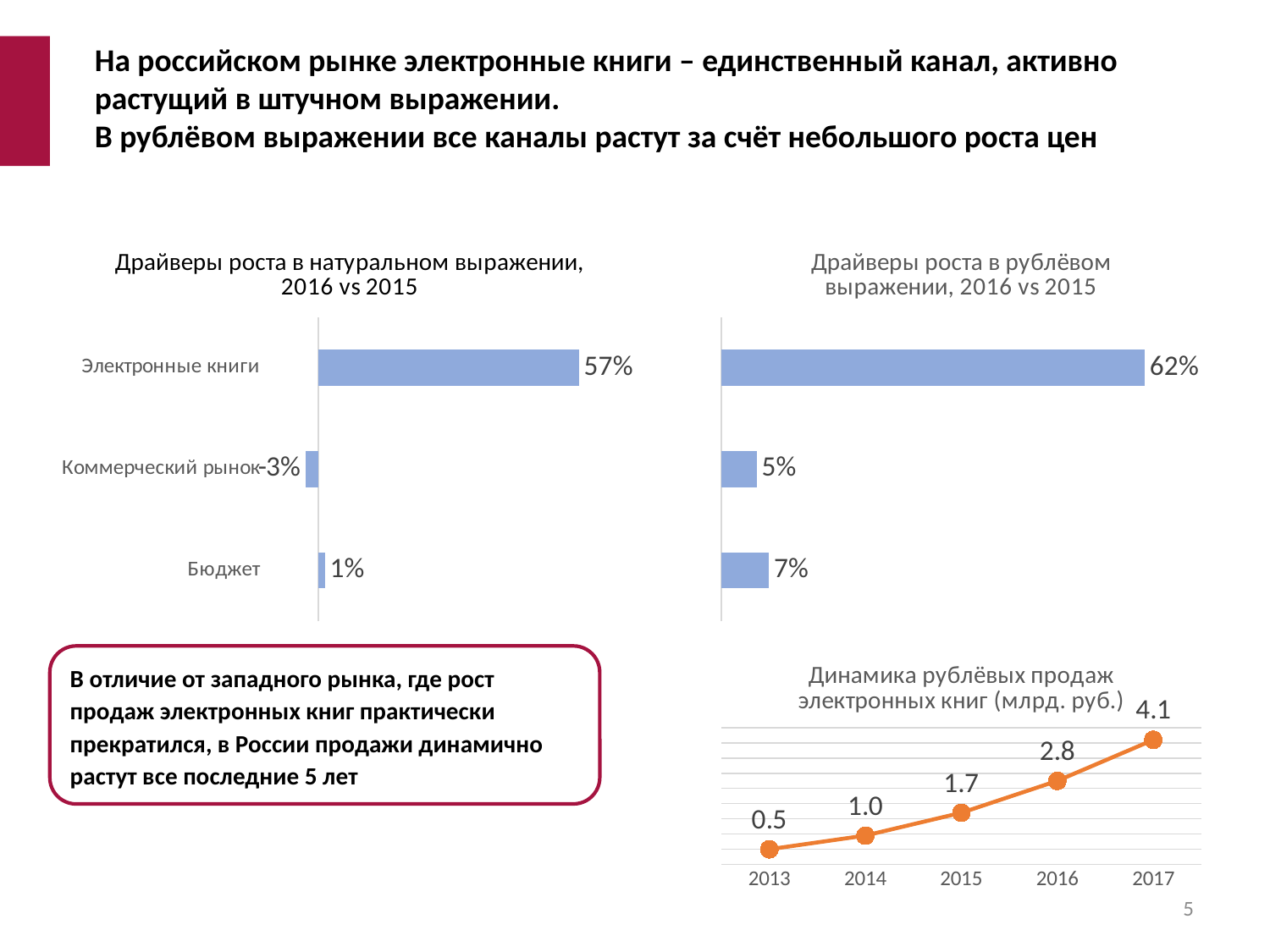
In the chart 'Драйверы роста в натуральном выражении, 2016 vs 2015', what is the value for Коммерческий рынок? -3% In the chart 'Драйверы роста в натуральном выражении, 2016 vs 2015', how many categories are shown? 3 In the chart 'Драйверы роста в рублёвом выражении, 2016 vs 2015', what is the value of the top bar (Электронные книги)? 62% In the chart 'Драйверы роста в натуральном выражении, 2016 vs 2015', which category has the lowest value? Коммерческий рынок In the chart 'Драйверы роста в рублёвом выражении, 2016 vs 2015', what is the value of the bottom bar (Бюджет)? 7% In the chart 'Динамика рублёвых продаж электронных книг (млрд. руб.)', do the values rise or fall from 2013 to 2017? Rise In the chart 'Динамика рублёвых продаж электронных книг (млрд. руб.)', what is the difference between the 2017 value and the 2013 value? 3.6 In the chart 'Динамика рублёвых продаж электронных книг (млрд. руб.)', which year has the highest value? 2017 In the chart 'Драйверы роста в натуральном выражении, 2016 vs 2015', what is the value for Электронные книги? 57% What kind of chart is 'Драйверы роста в рублёвом выражении, 2016 vs 2015'? Bar chart In the chart 'Динамика рублёвых продаж электронных книг (млрд. руб.)', what is the value for 2015? 1.7 In the chart 'Драйверы роста в рублёвом выражении, 2016 vs 2015', what is the difference between the top bar (62%) and the middle bar (5%)? 57%